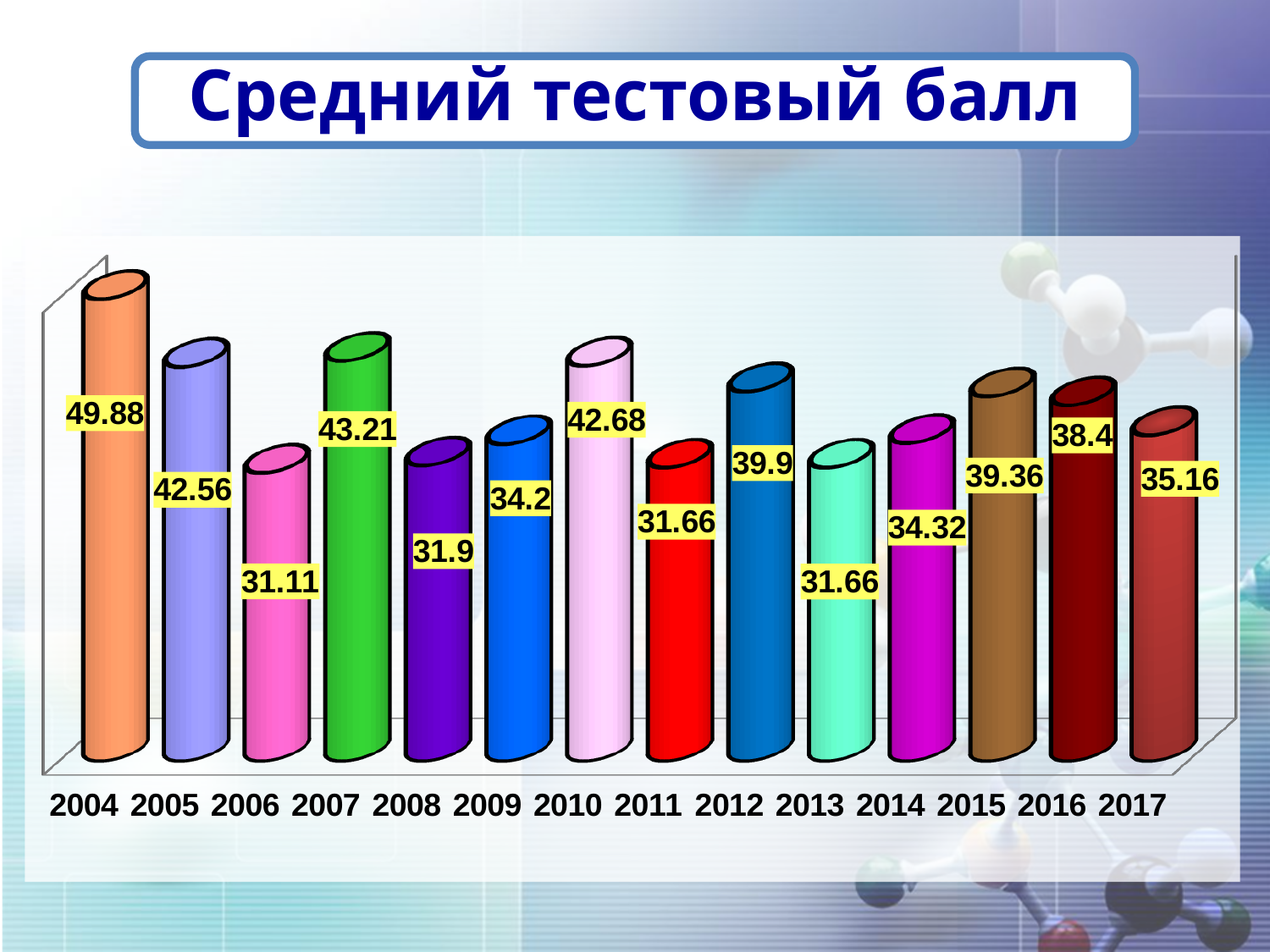
What is the difference between the values for 2004 and 2005? 7.32 What kind of chart is shown on the slide? Bar chart What value is shown for 2010? 42.68 What is the average test score shown for 2004? 49.88 Which year has the lowest average test score? 2006 What is the value for 2016? 38.4 How many years are shown on the chart? 14 Which is larger, the value for 2005 or the value for 2009? 2005 Which year has the highest average test score? 2004 What value is shown for 2014? 34.32 What is the difference between the values for 2007 and 2006? 12.1 What is the title of the chart? Средний тестовый балл